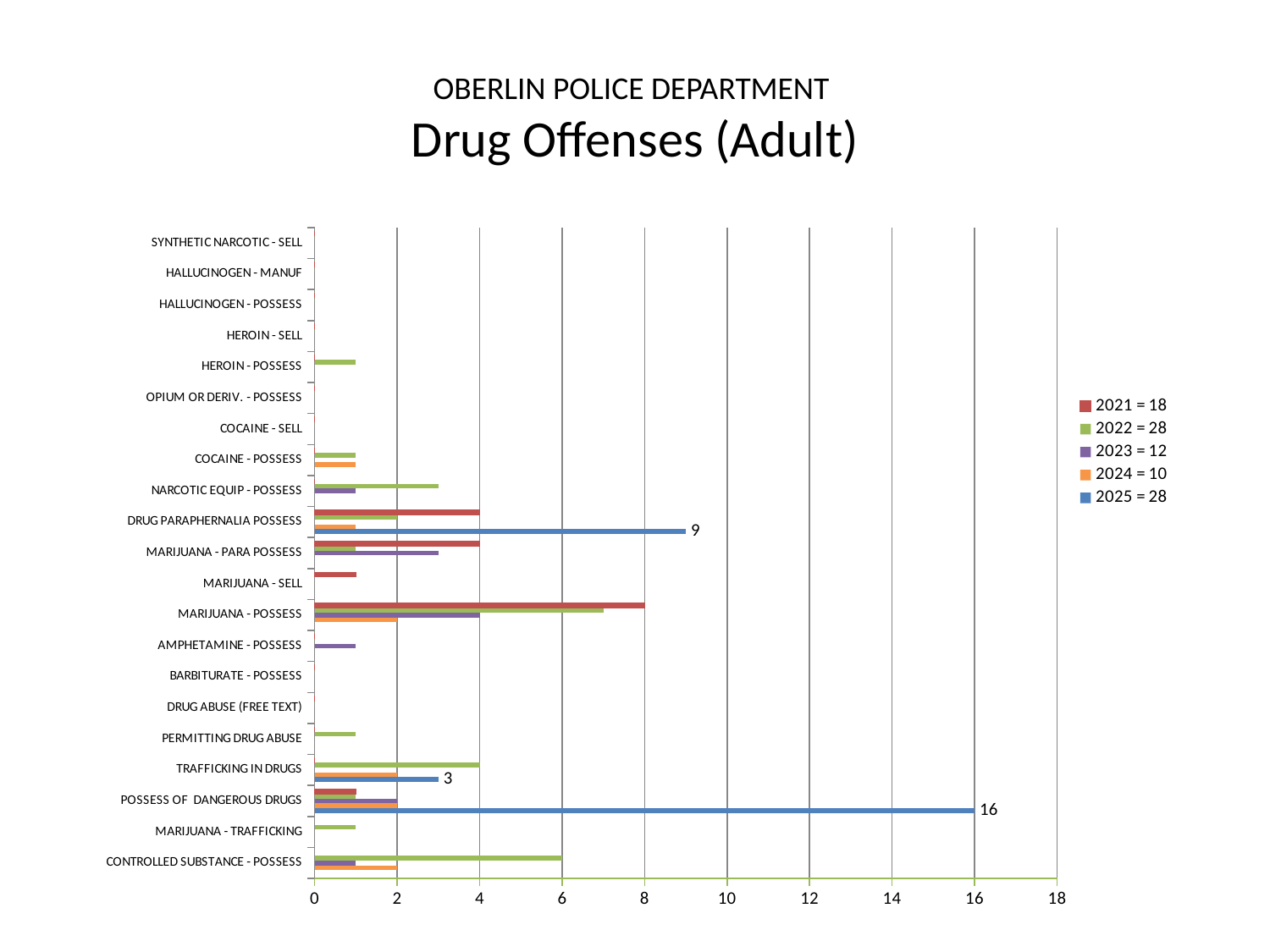
Which category has the highest 2025 value? POSSESS OF DANGEROUS DRUGS Which is larger: the 2021 value for MARIJUANA - POSSESS or the 2022 value for MARIJUANA - POSSESS? 2021 According to the legend, what is the total for 2022? 28 What is the 2025 value for TRAFFICKING IN DRUGS? 3 What is the 2025 value for POSSESS OF DANGEROUS DRUGS? 16 What is the 2025 value for DRUG PARAPHERNALIA POSSESS? 9 What type of chart is shown on the slide? bar chart How many series does the legend list? 5 What is the 2022 value for CONTROLLED SUBSTANCE - POSSESS? 6 What is the 2021 value for MARIJUANA - POSSESS? 8 Is the 2022 value for HEROIN - POSSESS greater or less than 2? less What is the difference between the 2025 value for POSSESS OF DANGEROUS DRUGS and the 2025 value for DRUG PARAPHERNALIA POSSESS? 7